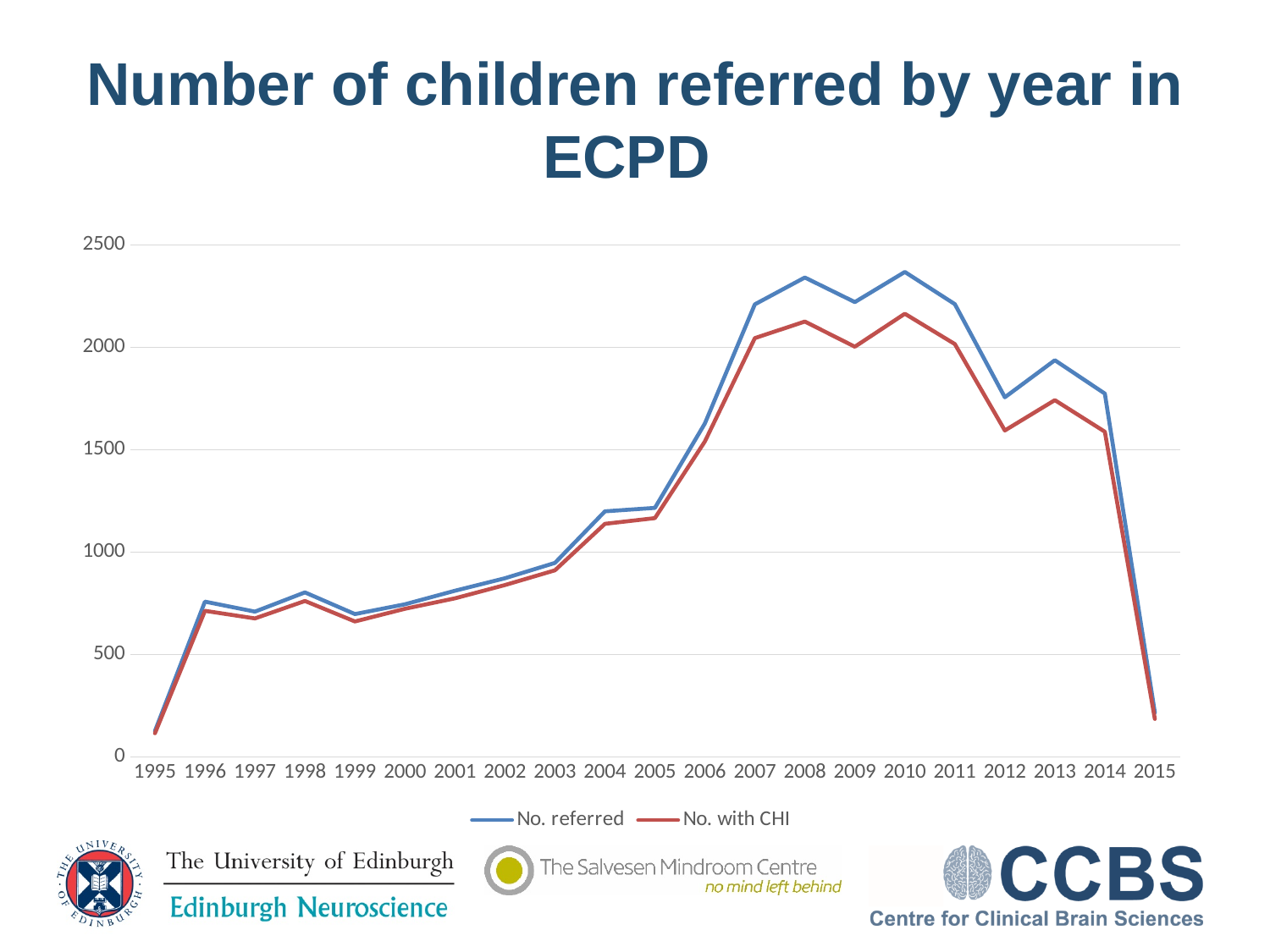
Do the values for No. with CHI rise or fall between 2013 and 2015? fall Is the value for No. with CHI in 1999 greater or less than 1000? less What is the title of the chart? Number of children referred by year in ECPD How many series does the legend list? 2 How many years are plotted along the x axis? 21 Is the value for No. with CHI in 2012 greater or less than 2000? less Is the value for No. referred in 2008 greater or less than 2000? greater Do the values for No. referred rise or fall between 2003 and 2008? rise In 2010, which series has the larger value, No. referred or No. with CHI? No. referred What kind of chart is shown on the slide? line chart